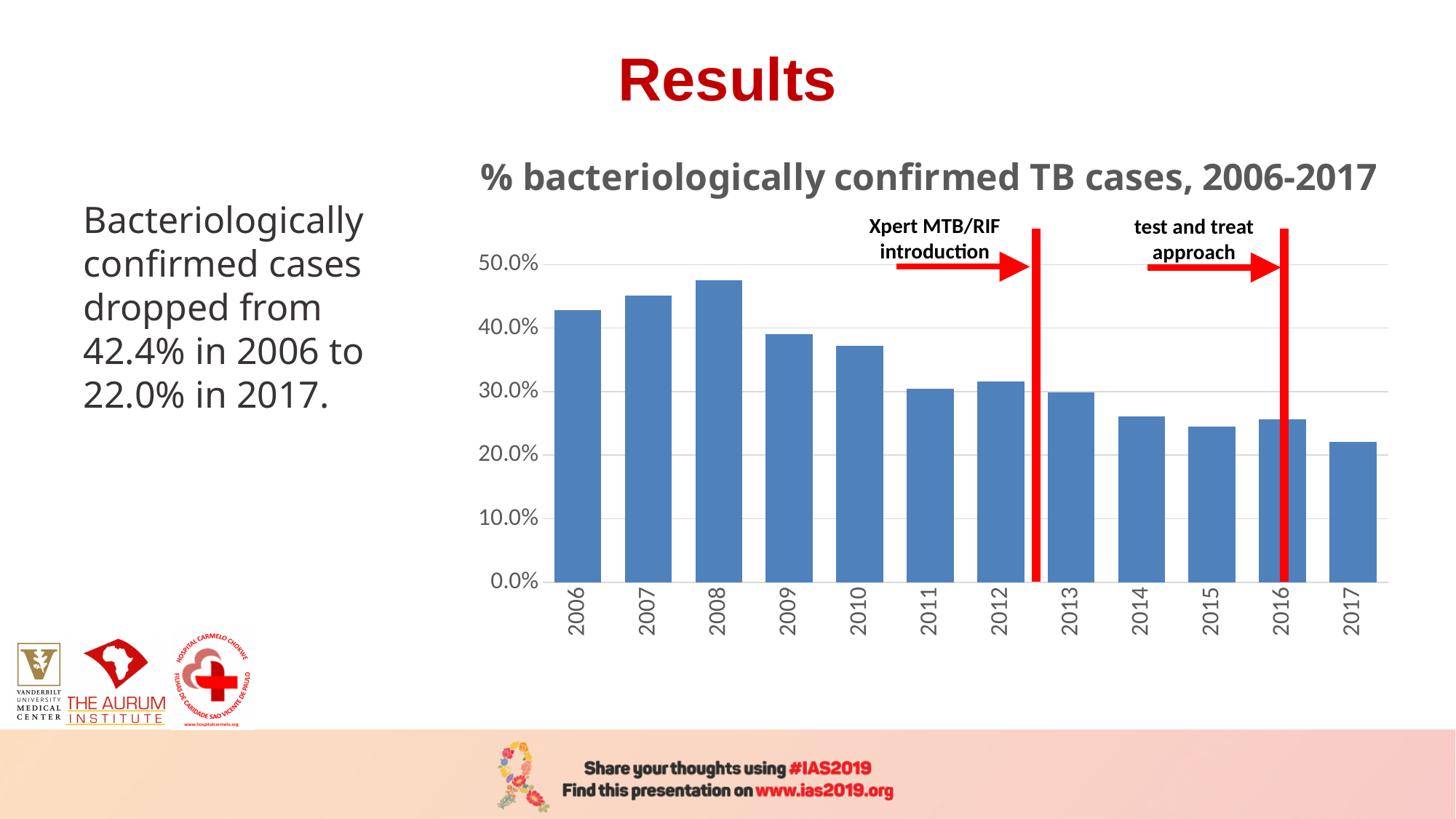
Overall, do the values rise or fall from 2006 to 2017? Fall What is the title of the chart? % bacteriologically confirmed TB cases, 2006-2017 What was the percentage of bacteriologically confirmed TB cases in 2017? 22.0% Is the value for 2008 greater or less than 40.0%? greater Which year has the lowest percentage of bacteriologically confirmed TB cases? 2017 Which year has a higher percentage of confirmed cases, 2007 or 2009? 2007 What kind of chart is shown on the slide? Bar chart How many years (bars) are plotted in the chart? 12 By how many percentage points did bacteriologically confirmed cases drop from 2006 to 2017? 20.4 percentage points Is the value for 2014 greater or less than 30.0%? less What was the percentage of bacteriologically confirmed TB cases in 2006? 42.4% Which year has the highest percentage of bacteriologically confirmed TB cases? 2008